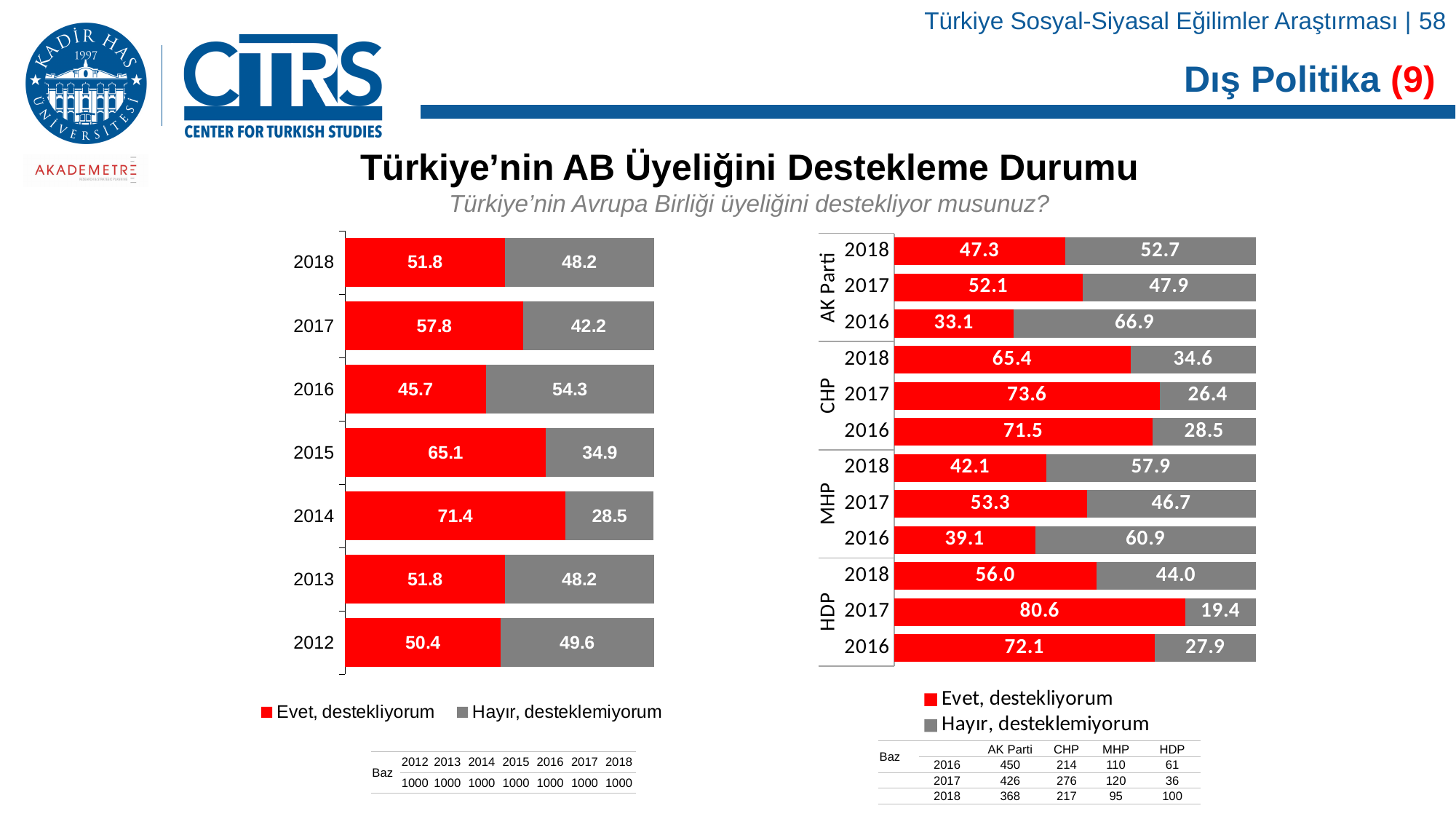
In the left chart by year, which year has the lowest "Evet, destekliyorum" value? 2016 In the right chart by party, what percentage of AK Parti respondents said "Hayır, desteklemiyorum" in 2016? 66.9 In the right chart by party, is the "Evet, destekliyorum" value for MHP 2018 or HDP 2018 larger? HDP 2018 In the left chart by year, how many years are shown? 7 In the left chart by year, what percentage said "Hayır, desteklemiyorum" in 2016? 54.3 In the right chart by party, how many series does the legend list? 2 In the right chart by party, what percentage of CHP respondents said "Evet, destekliyorum" in 2017? 73.6 In the left chart by year, which year has the highest "Evet, destekliyorum" value? 2014 In the left chart by year, what percentage said "Evet, destekliyorum" in 2018? 51.8 In the right chart by party, which party-year bar has the highest "Evet, destekliyorum" value? HDP 2017 In the left chart by year, what is the difference between the "Evet, destekliyorum" values for 2017 and 2018? 6.0 In the left chart by year, what kind of chart is it? Stacked bar chart